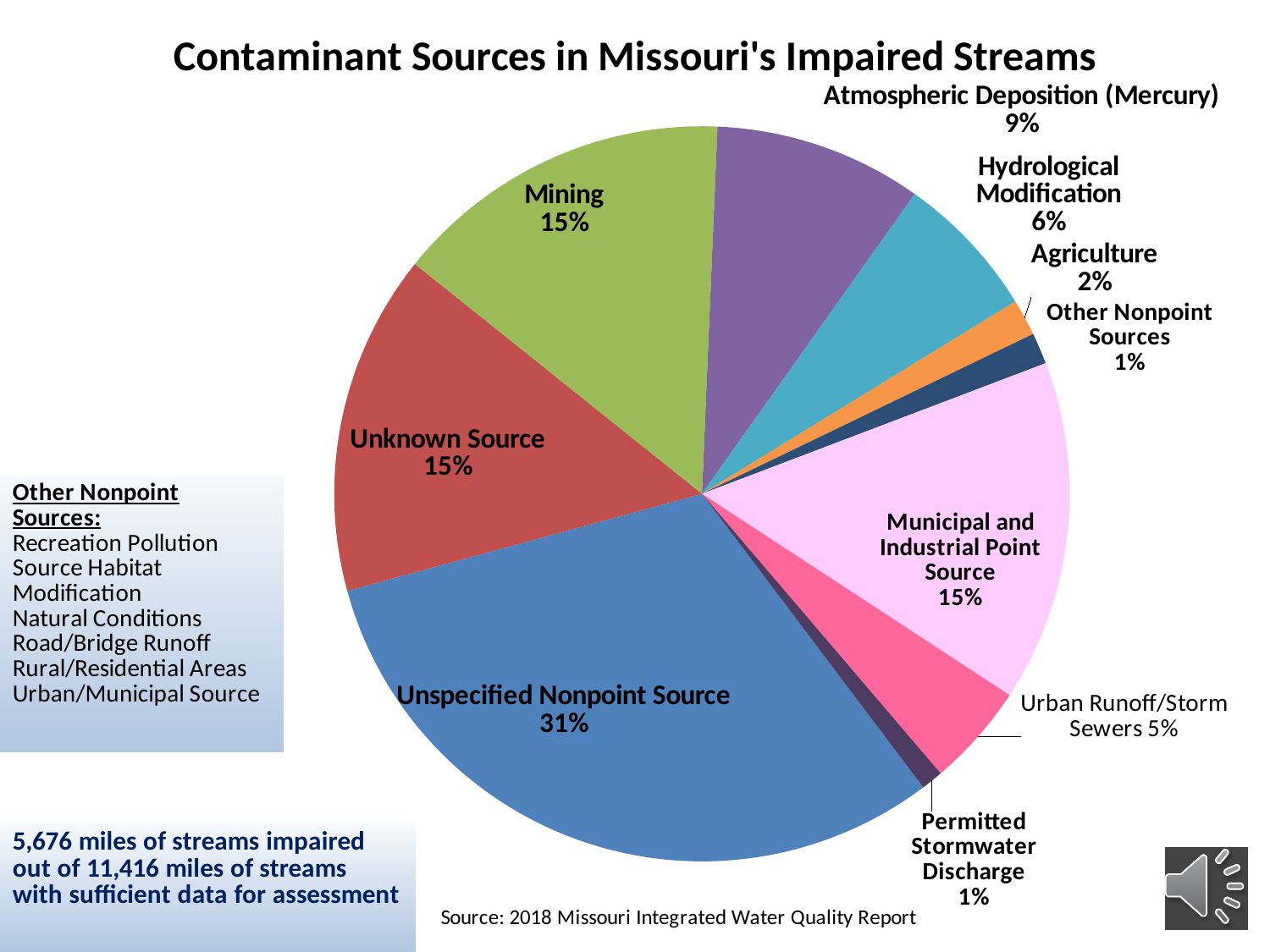
What is the difference in percentage points between Unspecified Nonpoint Source and Mining? 16 What share of the pie is Unspecified Nonpoint Source? 31% What percentage is shown for Atmospheric Deposition (Mercury)? 9% Which contaminant source has the largest slice of the pie? Unspecified Nonpoint Source How many slices does the pie chart have? 10 What is the difference in percentage points between Atmospheric Deposition (Mercury) and Agriculture? 7 What kind of chart is shown on the slide? pie chart What percentage is shown for Permitted Stormwater Discharge? 1% What is the title of the chart? Contaminant Sources in Missouri's Impaired Streams Which is larger, the slice for Hydrological Modification or the slice for Urban Runoff/Storm Sewers? Hydrological Modification What percentage is shown for Hydrological Modification? 6% What percentage is shown for Urban Runoff/Storm Sewers? 5%